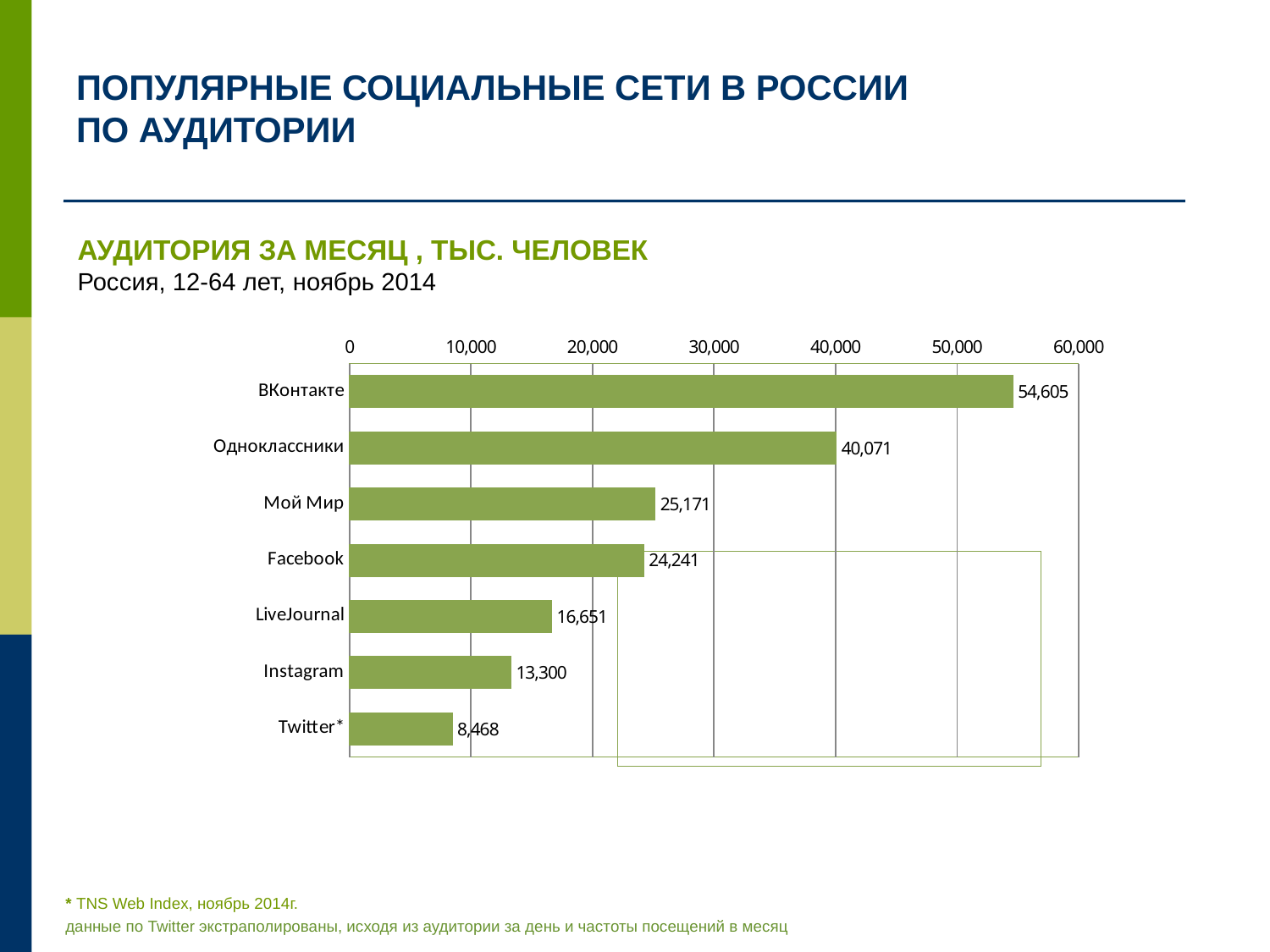
What is the monthly audience value shown for ВКонтакте? 54,605 What kind of chart is shown on the slide? bar chart How many social networks are shown on the chart? 7 Which social network has the lowest monthly audience on the chart? Twitter* What is the value shown for Instagram? 13,300 What is the difference between the values for ВКонтакте and Одноклассники? 14,534 What is the value shown for Facebook? 24,241 Is the value for Twitter* greater or less than 10,000? less What is the maximum value shown on the chart's axis? 60,000 Which social network has the highest monthly audience on the chart? ВКонтакте Which has a larger value, Одноклассники or Мой Мир? Одноклассники What is the difference between the values for LiveJournal and Instagram? 3,351